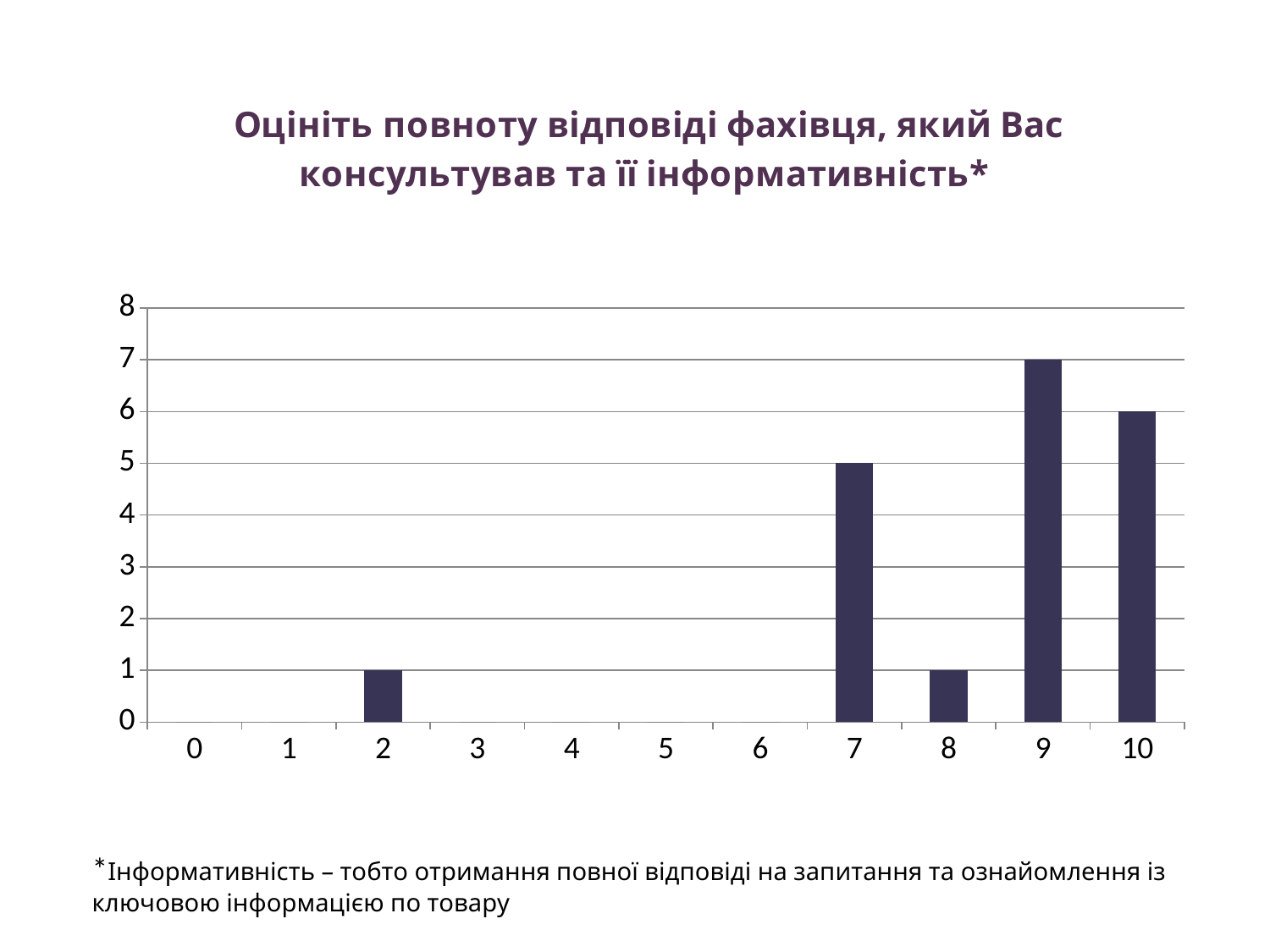
What type of chart is shown on the slide? bar chart What is the difference between the values for category 9 and category 10? 1 What is the value for category 9? 7 What is the value for category 7? 5 What is the value for category 8? 1 Is the value for category 9 greater or less than 5? greater How many categories are shown on the x axis? 11 What is the value for category 2? 1 Which is larger, the value for category 7 or the value for category 10? 10 Which category has the highest bar? 9 What is the maximum value shown on the y axis? 8 What is the value for category 10? 6